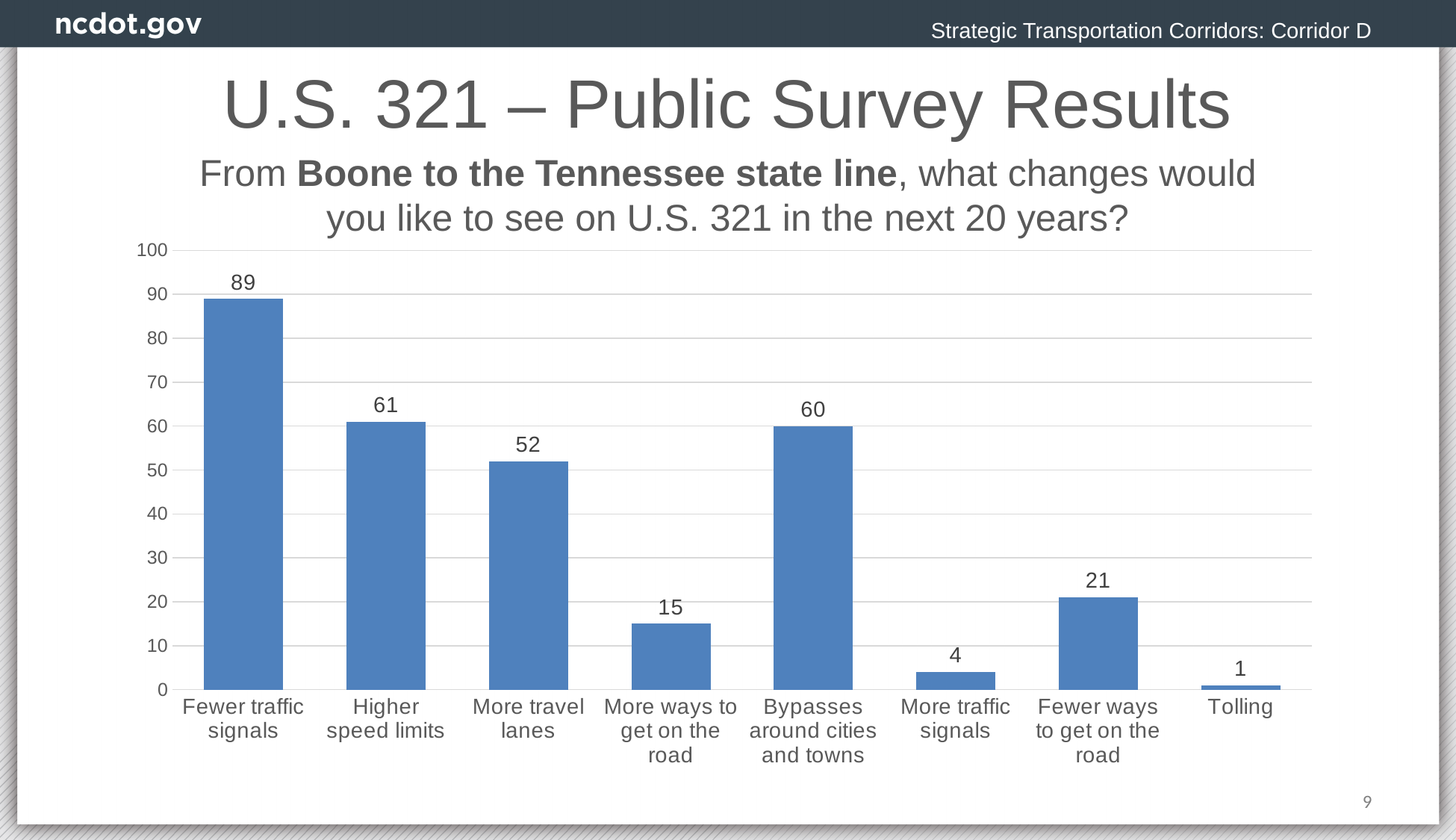
Is the value for "More travel lanes" greater or less than 50? greater What is the value for "More traffic signals"? 4 Which category has the highest value? Fewer traffic signals What is the value for "Bypasses around cities and towns"? 60 What is the value for "Tolling"? 1 What is the difference between the values for "Fewer traffic signals" and "Higher speed limits"? 28 What is the difference between the values for "Fewer ways to get on the road" and "More ways to get on the road"? 6 What is the value for "Fewer traffic signals"? 89 Which is larger, the value for "More travel lanes" or the value for "Bypasses around cities and towns"? Bypasses around cities and towns How many categories are shown on the x axis? 8 Which category has the lowest value? Tolling What kind of chart is shown on the slide? Bar chart